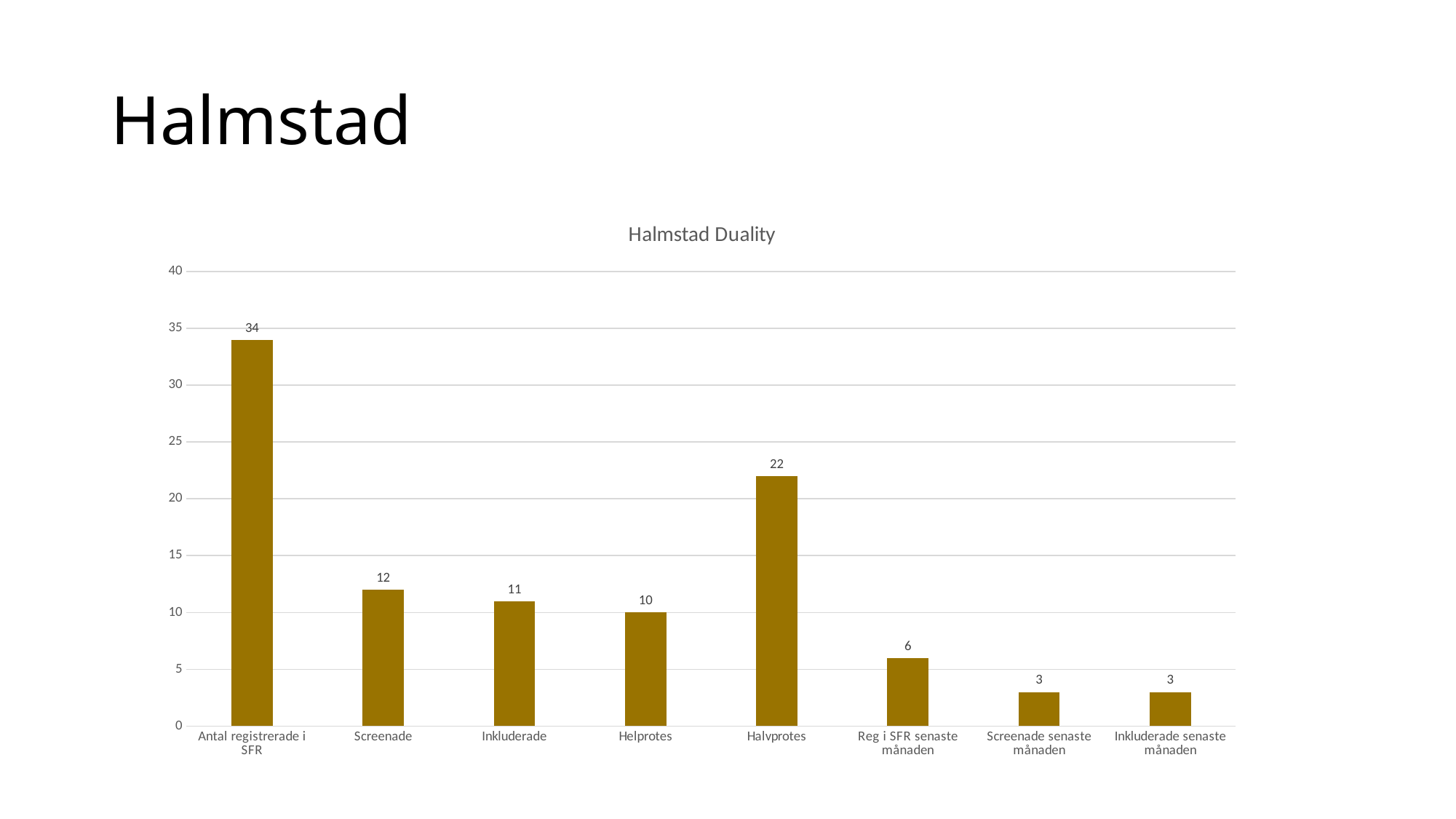
Which is larger, Halvprotes or Helprotes? Halvprotes What is the value for Reg i SFR senaste månaden? 6 What kind of chart is shown? bar chart Which category has the highest value? Antal registrerade i SFR What is the value for Halvprotes? 22 What is the title of the chart? Halmstad Duality What is the value for Antal registrerade i SFR? 34 What is the value for Helprotes? 10 How many categories are shown on the x axis? 8 Is the value for Screenade greater or less than 10? greater What is the difference between Screenade and Inkluderade? 1 What is the difference between Antal registrerade i SFR and Halvprotes? 12